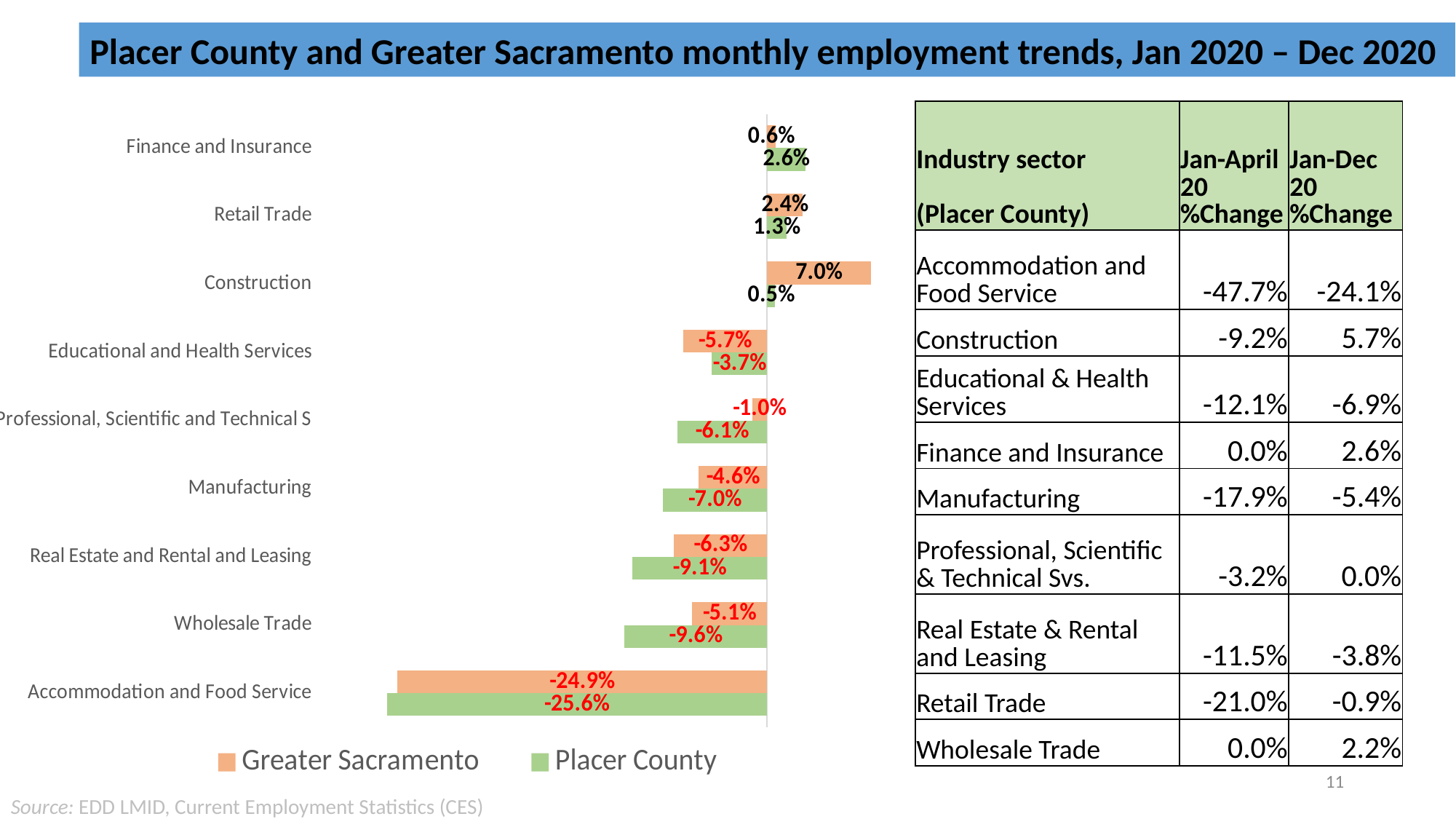
What is the Greater Sacramento value for Construction in the chart? 7.0% Which category has the lowest Placer County value in the chart? Accommodation and Food Service For Real Estate and Rental and Leasing, which series has the larger value in the chart, Greater Sacramento or Placer County? Greater Sacramento What is the Placer County value for Finance and Insurance in the chart? 2.6% How many series does the chart legend list? 2 What is the Greater Sacramento value for Accommodation and Food Service in the chart? -24.9% What kind of chart is shown on the slide? bar chart What is the difference between the Greater Sacramento and Placer County values for Manufacturing in the chart? 2.4% What is the Placer County value for Wholesale Trade in the chart? -9.6% How many industry categories are plotted in the chart? 9 Which colour represents Placer County in the chart legend? green Which category has the highest Greater Sacramento value in the chart? Construction